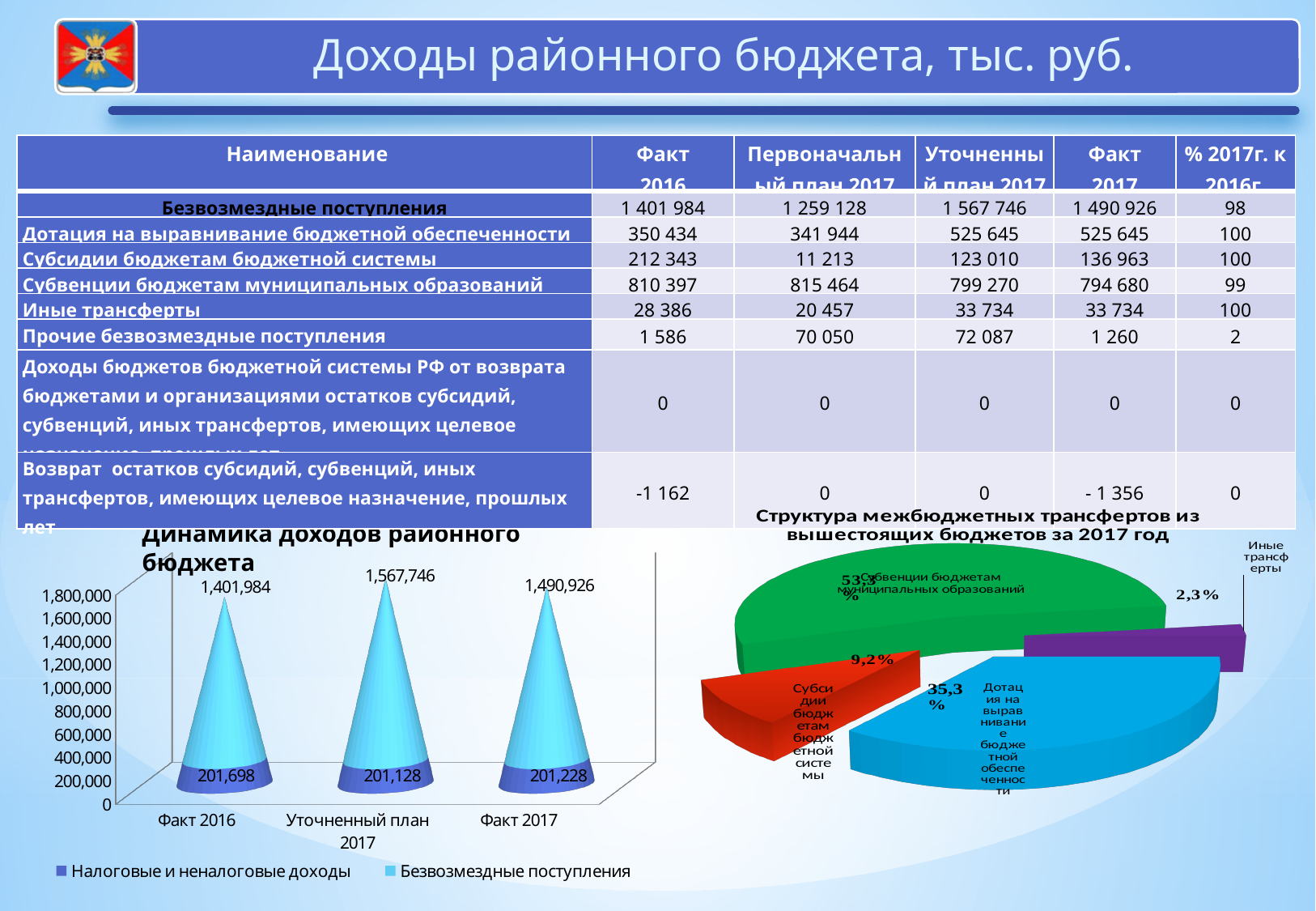
In the pie chart 'Структура межбюджетных трансфертов из вышестоящих бюджетов за 2017 год', what share do 'Субвенции бюджетам муниципальных образований' have? 53,3% In the chart 'Динамика доходов районного бюджета', what is the value of 'Безвозмездные поступления' for 'Уточненный план 2017'? 1,567,746 In the chart 'Динамика доходов районного бюджета', what is the value of 'Налоговые и неналоговые доходы' for 'Факт 2016'? 201,698 In the chart 'Динамика доходов районного бюджета', how many series does the legend list? 2 In the pie chart 'Структура межбюджетных трансфертов из вышестоящих бюджетов за 2017 год', what share do 'Субсидии бюджетам бюджетной системы' have? 9,2% What kind of chart is 'Структура межбюджетных трансфертов из вышестоящих бюджетов за 2017 год'? Pie chart What kind of chart is 'Динамика доходов районного бюджета'? Bar chart In the chart 'Динамика доходов районного бюджета', what is the value of 'Безвозмездные поступления' for 'Факт 2017'? 1,490,926 In the chart 'Динамика доходов районного бюджета', how many categories are shown on the x axis? 3 In the chart 'Динамика доходов районного бюджета', which category has the highest value for 'Безвозмездные поступления'? Уточненный план 2017 In the pie chart 'Структура межбюджетных трансфертов из вышестоящих бюджетов за 2017 год', which slice is the smallest? Иные трансферты In the chart 'Динамика доходов районного бюджета', what is the difference between 'Безвозмездные поступления' for 'Уточненный план 2017' and for 'Факт 2016'? 165,762